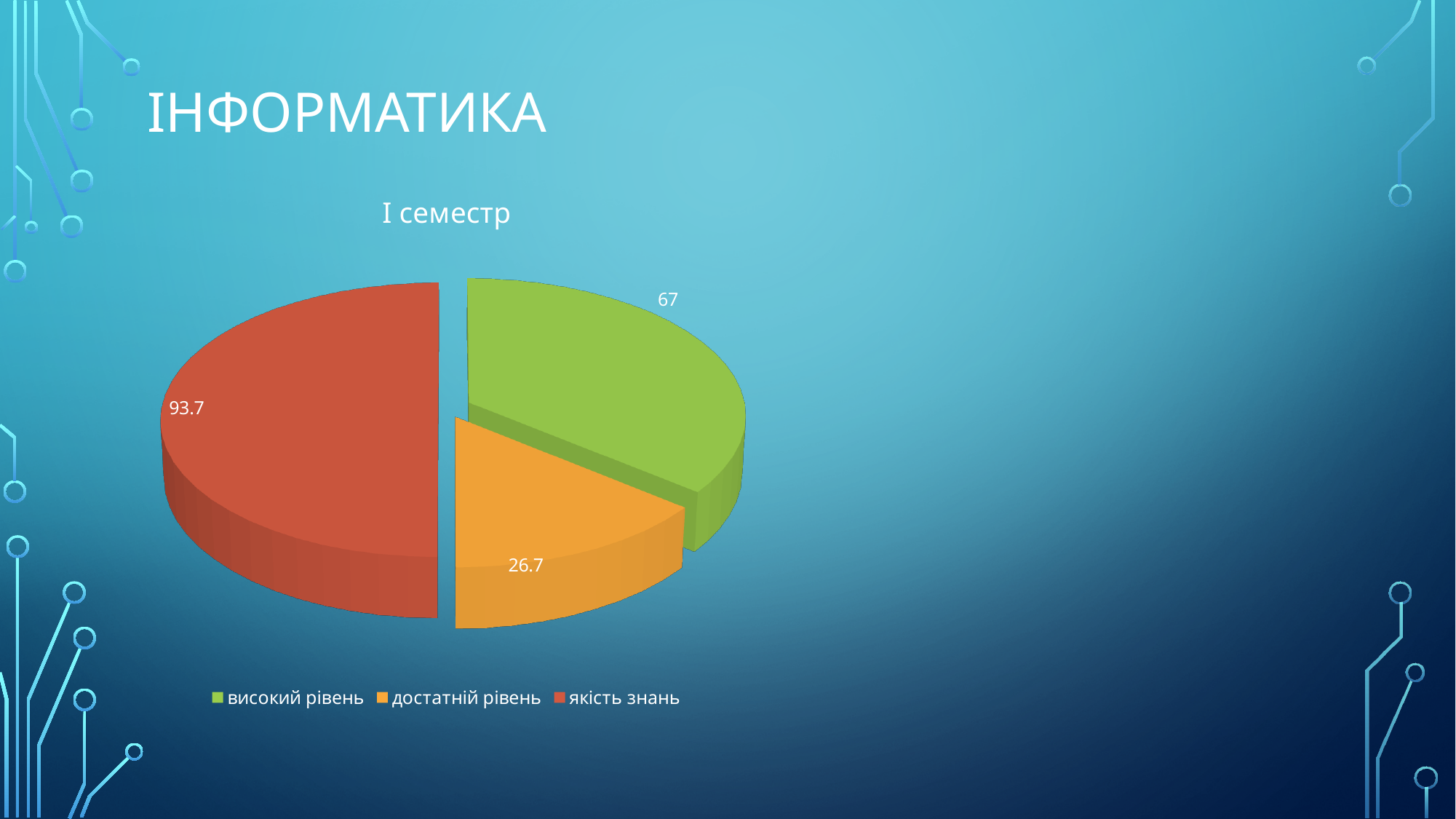
What is the difference between the values for якість знань and високий рівень? 26.7 Which category has the largest slice? якість знань What is the difference between the values for високий рівень and достатній рівень? 40.3 Which category has the smallest slice? достатній рівень What is the value for високий рівень? 67 How many slices does the pie chart have? 3 Which is larger, the value for високий рівень or the value for достатній рівень? високий рівень What is the value for достатній рівень? 26.7 What colour is the slice for якість знань? red What is the value for якість знань? 93.7 What type of chart is shown on the slide? pie chart What is the title of the chart? І семестр